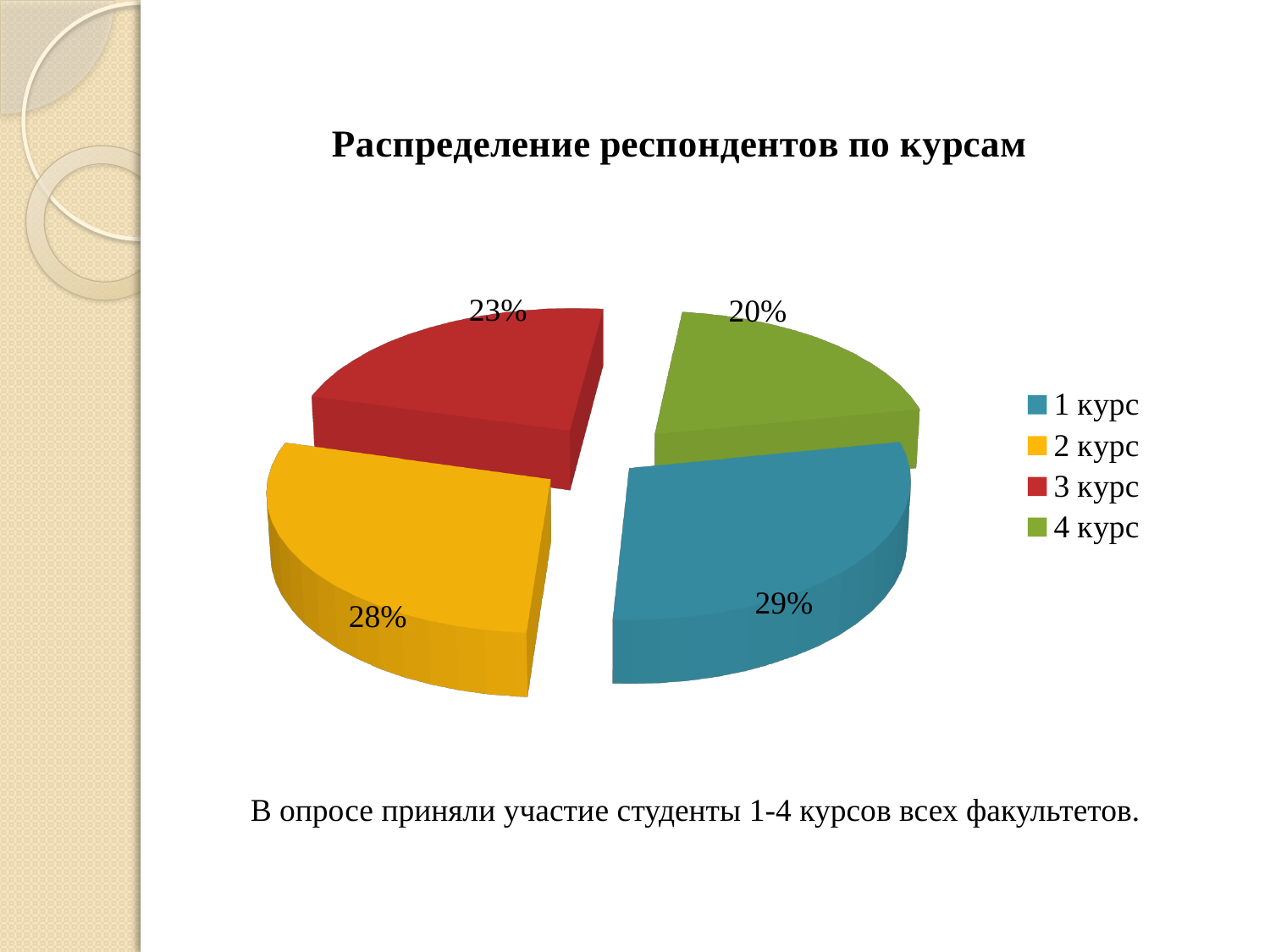
What is the difference in percentage points between the shares for 1 курс and 4 курс? 9 Which course has the smallest share of respondents? 4 курс What is the title of the chart? Распределение респондентов по курсам What share of respondents are in 1 курс? 29% What share of respondents are in 4 курс? 20% Which course has the largest share of respondents? 1 курс What share of respondents are in 2 курс? 28% How many slices does the pie chart have? 4 What share of respondents are in 3 курс? 23% Which has a larger share of respondents, 3 курс or 4 курс? 3 курс What is the difference in percentage points between the shares for 2 курс and 3 курс? 5 What kind of chart is shown on the slide? Pie chart